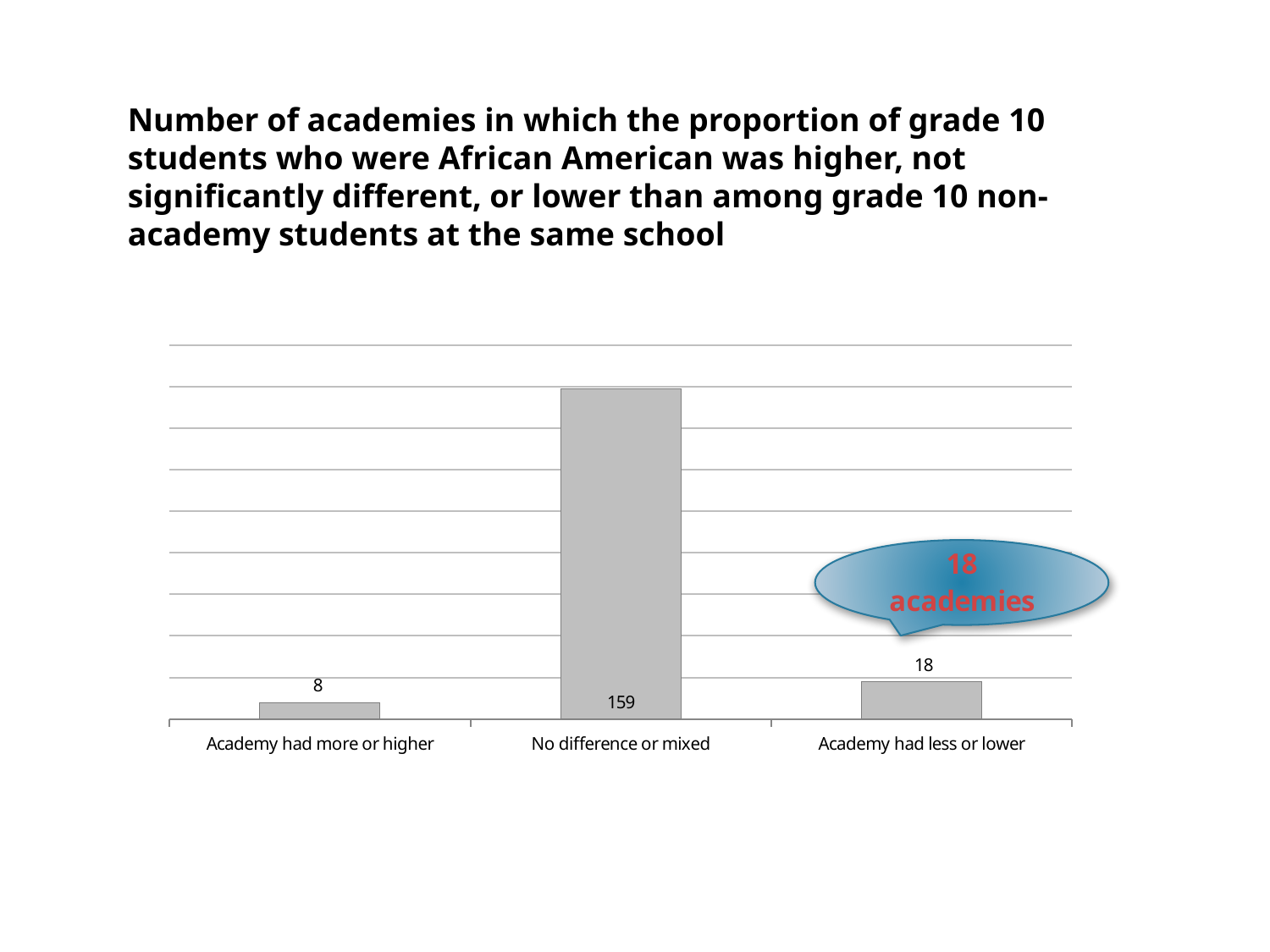
What is the total of the three values shown in the chart? 185 What kind of chart is shown on the slide? Bar chart What is the value for "Academy had less or lower"? 18 How many categories are shown on the x axis? 3 Which category has the lowest value? Academy had more or higher What is the difference between the values for "Academy had less or lower" and "Academy had more or higher"? 10 What is the value for "No difference or mixed"? 159 Which category has the highest value? No difference or mixed What is the difference between the values for "No difference or mixed" and "Academy had less or lower"? 141 What does the callout bubble on the chart say? 18 academies Which is larger, the value for "Academy had less or lower" or the value for "Academy had more or higher"? Academy had less or lower What is the value for "Academy had more or higher"? 8